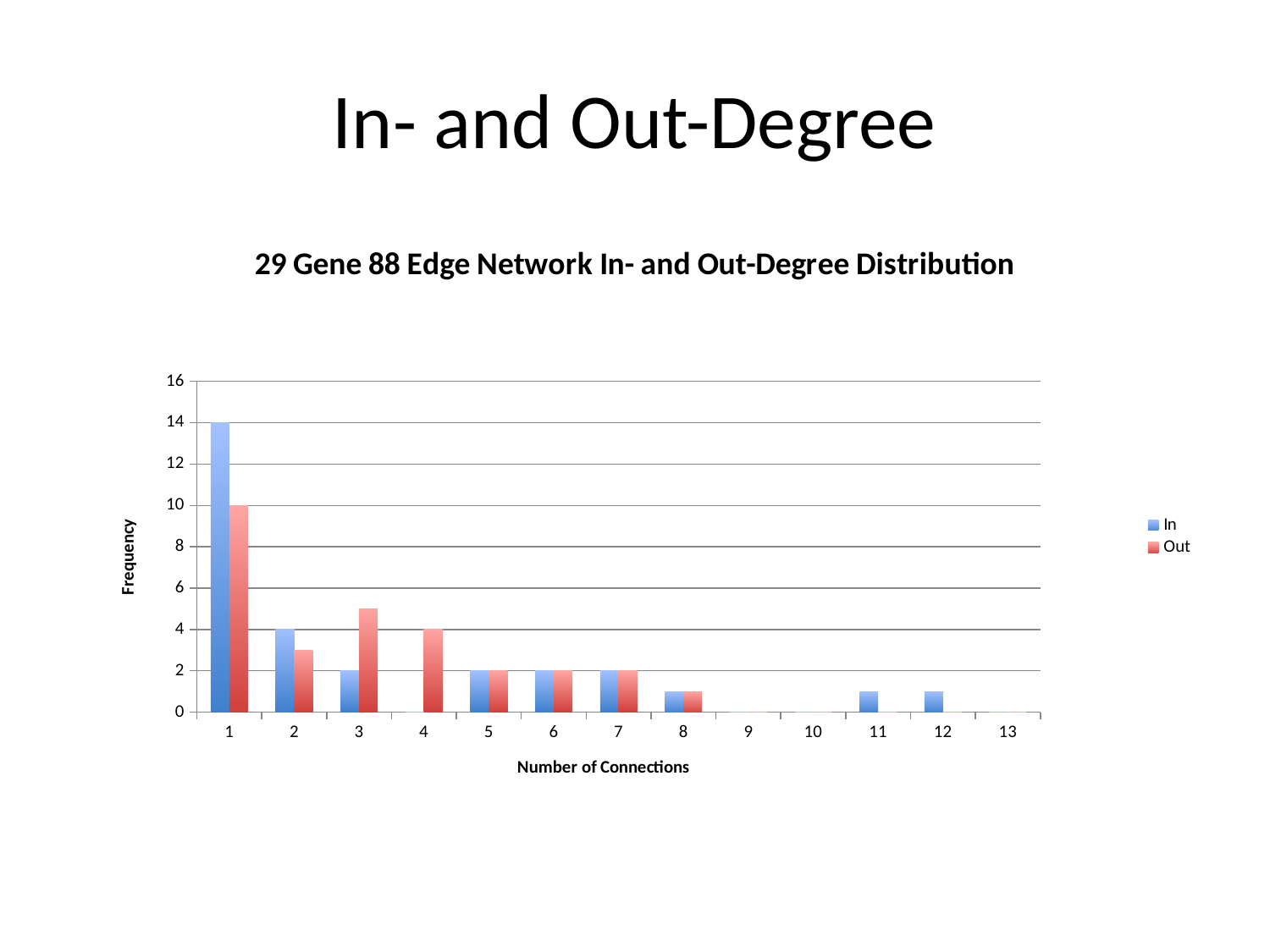
For 3 connections, which series has the larger frequency, In or Out? Out What is the difference between the In and Out frequencies for 1 connection? 4 What is the In frequency for 1 connection? 14 How many series does the legend list? 2 What is the Out frequency for 4 connections? 4 What is the Out frequency for 1 connection? 10 How many categories are shown on the x axis? 13 What is the title of the chart? 29 Gene 88 Edge Network In- and Out-Degree Distribution Is the In frequency for 11 connections greater or less than 2? less What is the In frequency for 2 connections? 4 Which number of connections has the highest In frequency? 1 Is the Out frequency for 3 connections greater or less than 4? greater